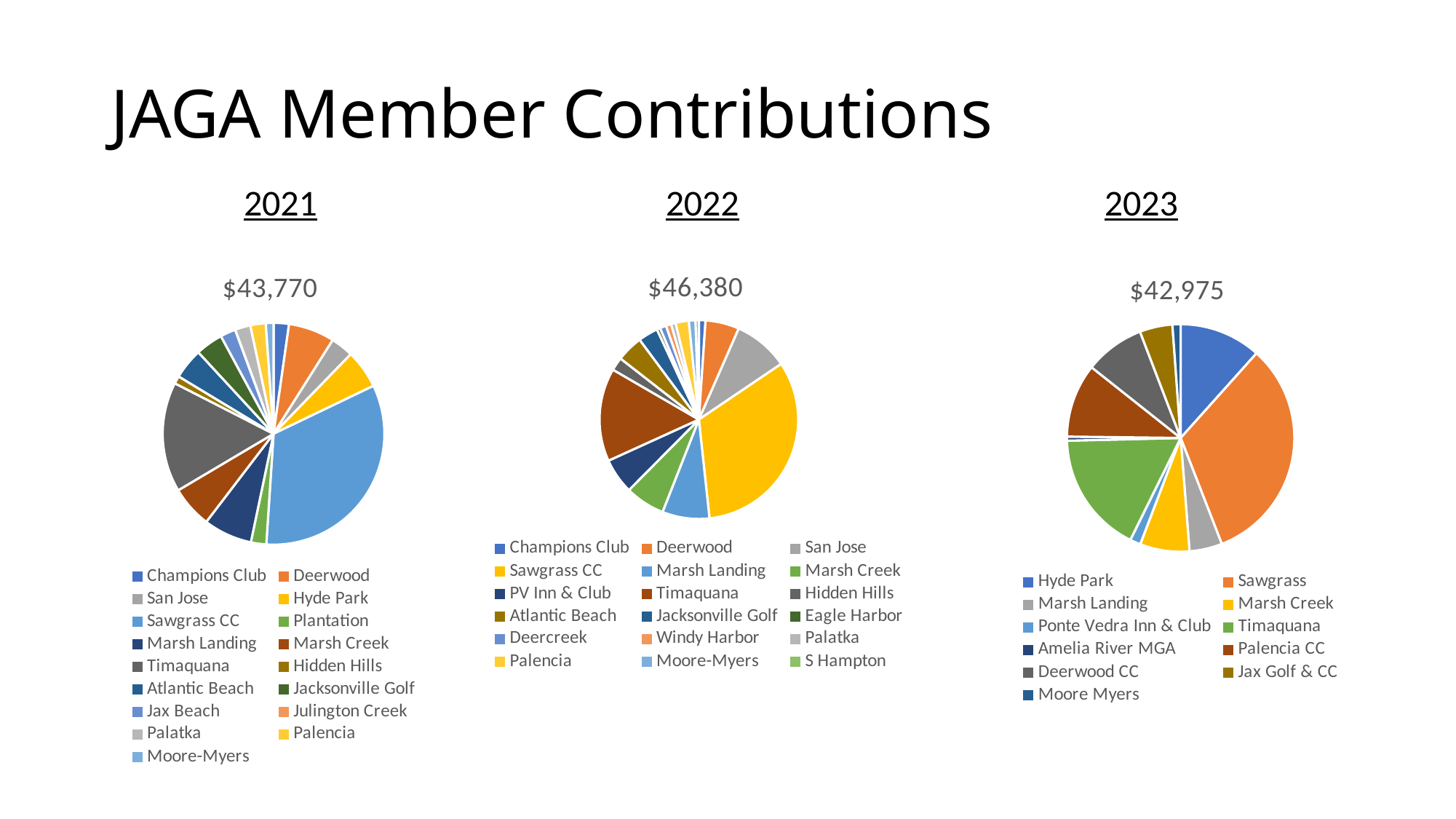
In the 2021 pie chart, which club has the largest slice? Sawgrass CC Which year has the highest total member contributions? 2022 What is the difference between the 2022 total and the 2021 total? $2,610 What total is printed above the 2023 pie chart? $42,975 What kind of charts are shown on the slide? Pie charts How many pie charts are on the slide? 3 What total is printed above the 2021 pie chart? $43,770 Which year has the lowest total member contributions? 2023 How many clubs are listed in the legend of the 2022 pie chart? 18 How many clubs are listed in the legend of the 2023 pie chart? 11 What total is printed above the 2022 pie chart? $46,380 In the 2023 pie chart, which club has the largest slice? Sawgrass